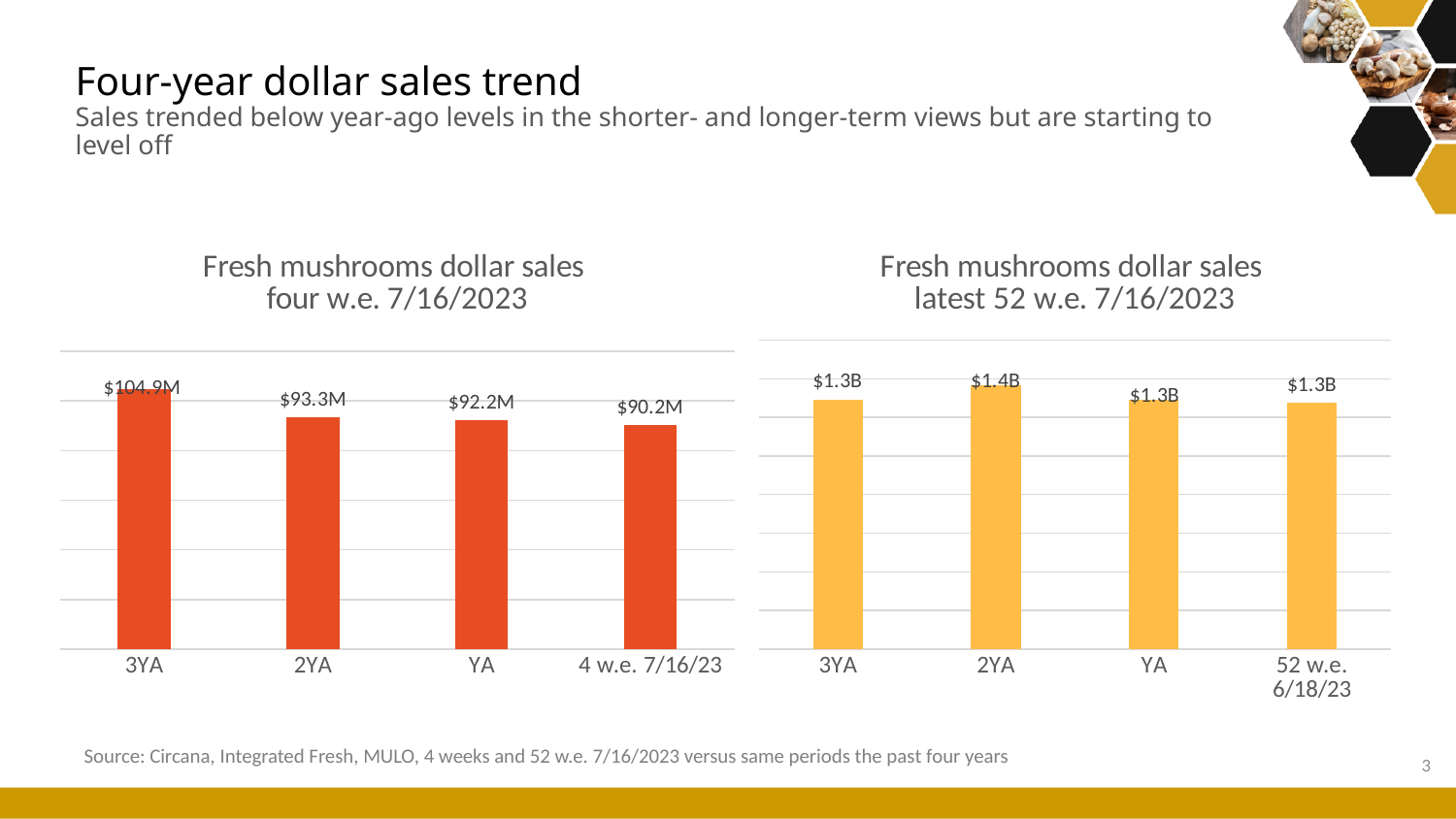
In the chart titled 'Fresh mushrooms dollar sales four w.e. 7/16/2023', what is the difference between the 2YA value and the YA value? $1.0M In the chart titled 'Fresh mushrooms dollar sales four w.e. 7/16/2023', what is the value for 4 w.e. 7/16/23? $90.2M In the chart titled 'Fresh mushrooms dollar sales four w.e. 7/16/2023', what is the difference between the 3YA value and the 4 w.e. 7/16/23 value? $14.7M In the chart titled 'Fresh mushrooms dollar sales latest 52 w.e. 7/16/2023', how many categories are shown on the x axis? 4 What kind of chart is the chart titled 'Fresh mushrooms dollar sales four w.e. 7/16/2023'? bar chart In the chart titled 'Fresh mushrooms dollar sales four w.e. 7/16/2023', do the values rise or fall from 3YA to 4 w.e. 7/16/23? fall In the chart titled 'Fresh mushrooms dollar sales latest 52 w.e. 7/16/2023', what is the value for 2YA? $1.4B In the chart titled 'Fresh mushrooms dollar sales four w.e. 7/16/2023', which category has the lowest value? 4 w.e. 7/16/23 In the chart titled 'Fresh mushrooms dollar sales four w.e. 7/16/2023', which category has the highest value? 3YA In the chart titled 'Fresh mushrooms dollar sales four w.e. 7/16/2023', what is the value for 3YA? $104.9M In the chart titled 'Fresh mushrooms dollar sales latest 52 w.e. 7/16/2023', what is the value for 52 w.e. 6/18/23? $1.3B In the chart titled 'Fresh mushrooms dollar sales latest 52 w.e. 7/16/2023', which category has the highest value? 2YA